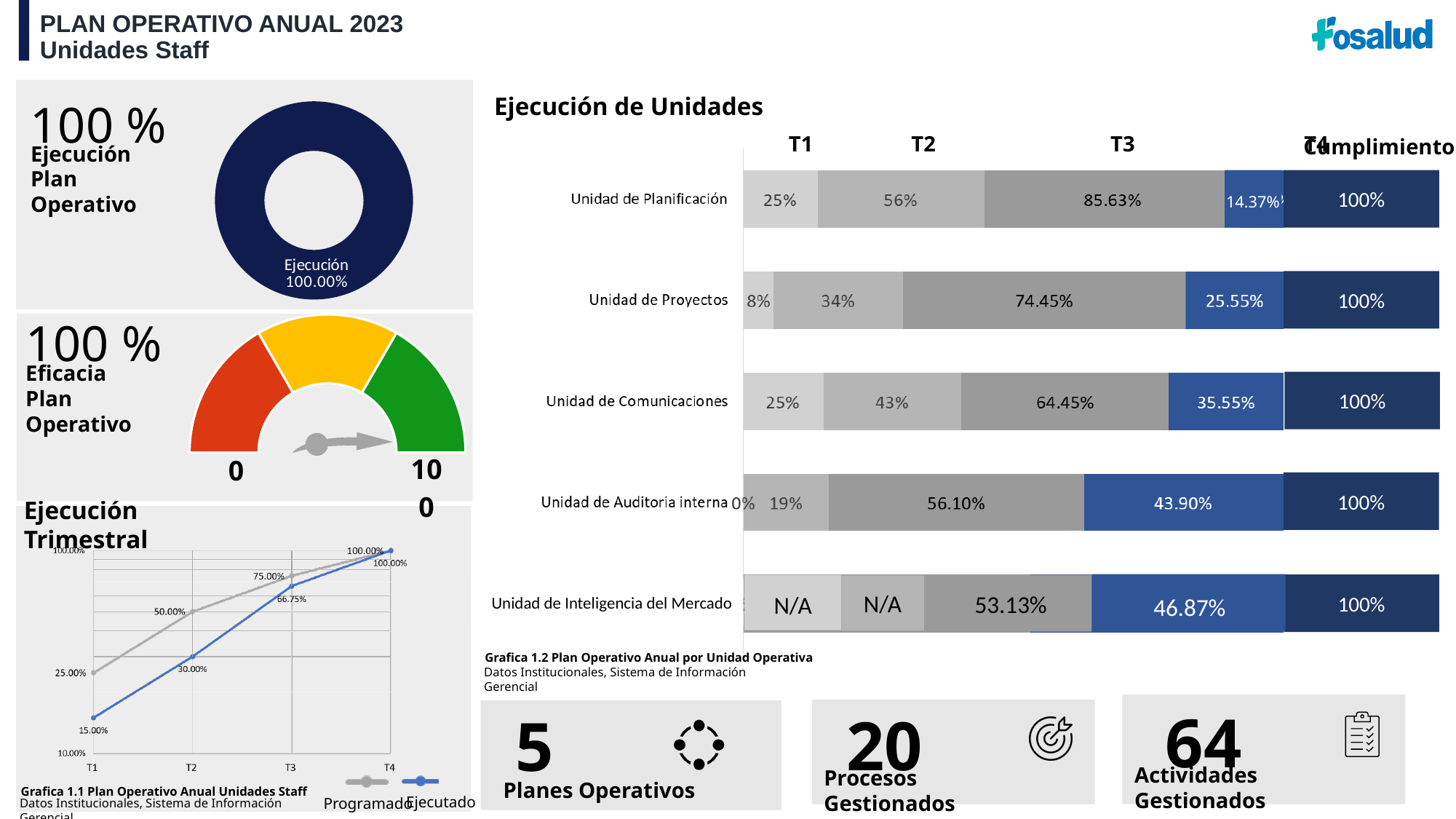
In the 'Ejecución de Unidades' chart, what is the T2 value for Unidad de Proyectos? 34% In the 'Ejecución de Unidades' chart, how many units are listed? 5 In the 'Ejecución de Unidades' chart, which unit has the highest T3 value? Unidad de Planificación In the 'Ejecución Trimestral' line chart, what is the Programado value at T2? 50.00% In the 'Ejecución de Unidades' chart, what is the T3 value for Unidad de Planificación? 85.63% In the 'Ejecución de Unidades' chart, what is the difference between the T4 values of Unidad de Comunicaciones and Unidad de Planificación? 21.18% In the 'Ejecución Trimestral' line chart, what is the Ejecutado value at T3? 66.75% In the 'Ejecución de Unidades' chart, which is larger: the T3 value for Unidad de Proyectos or for Unidad de Comunicaciones? Unidad de Proyectos In the 'Ejecución Trimestral' line chart, how many series does the legend list? 2 In the 'Ejecución de Unidades' chart, what is the T4 value for Unidad de Auditoria interna? 43.90% In the 'Ejecución de Unidades' chart, which unit has the lowest T3 value? Unidad de Inteligencia del Mercado In the 'Ejecución Trimestral' line chart, do the Ejecutado values rise or fall from T1 to T4? rise